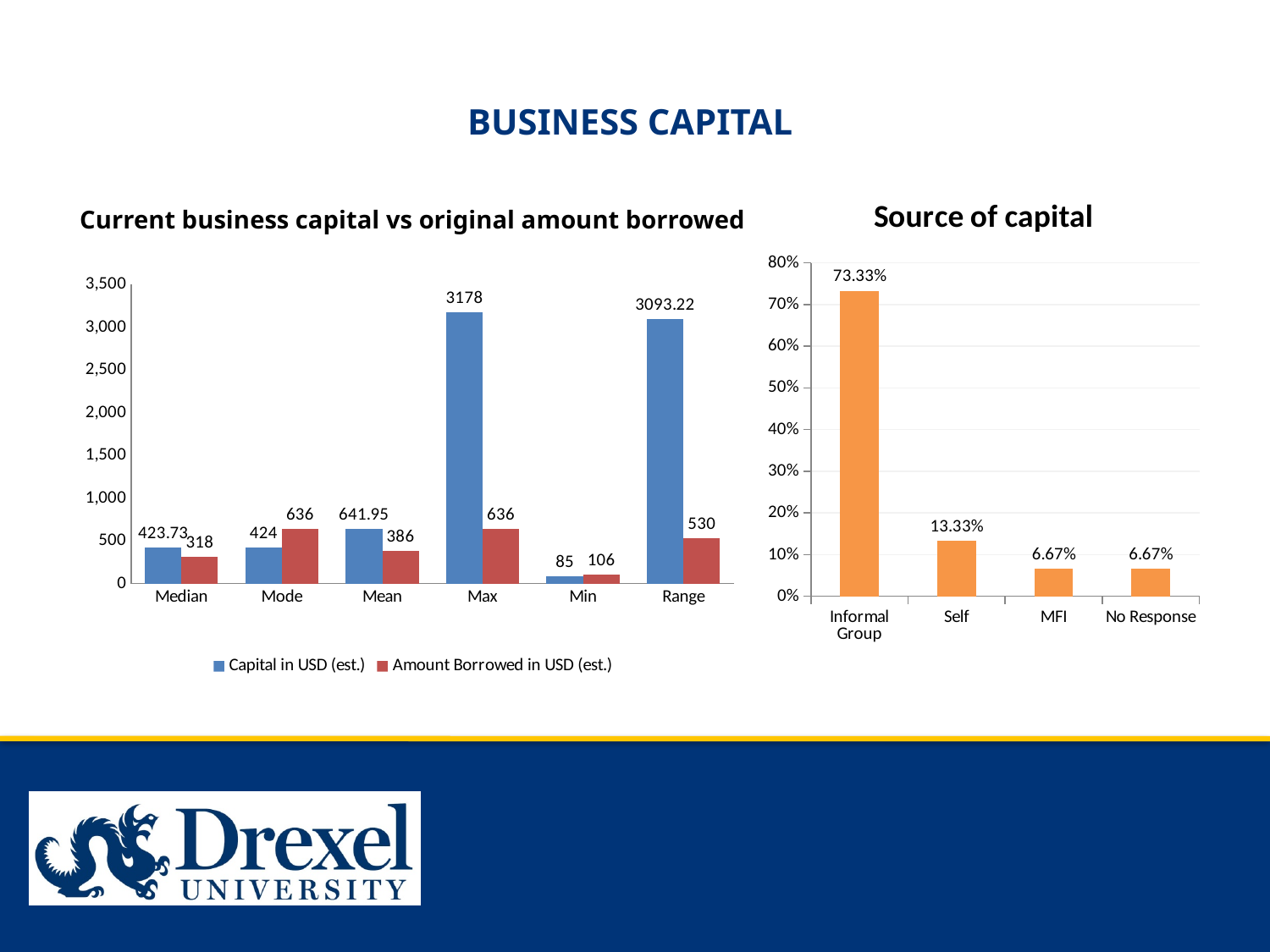
How many categories are shown on the x axis of the 'Current business capital vs original amount borrowed' chart? 6 In the 'Source of capital' chart, which category has the highest value? Informal Group In the 'Current business capital vs original amount borrowed' chart, for Mode, which is larger: Capital in USD (est.) or Amount Borrowed in USD (est.)? Amount Borrowed in USD (est.) In the 'Source of capital' chart, what is the difference between Informal Group and Self? 60.00% In the 'Current business capital vs original amount borrowed' chart, what is the Capital in USD (est.) value for Max? 3178 In the 'Source of capital' chart, what is the value for Self? 13.33% In the 'Current business capital vs original amount borrowed' chart, what is the difference between Capital in USD (est.) and Amount Borrowed in USD (est.) for Max? 2542 In the 'Current business capital vs original amount borrowed' chart, what is the Capital in USD (est.) value for Mean? 641.95 In the 'Current business capital vs original amount borrowed' chart, which category has the lowest Capital in USD (est.) value? Min In the 'Current business capital vs original amount borrowed' chart, what is the Amount Borrowed in USD (est.) value for Median? 318 What kind of chart is the 'Source of capital' chart? Bar chart How many series does the legend of the 'Current business capital vs original amount borrowed' chart list? 2